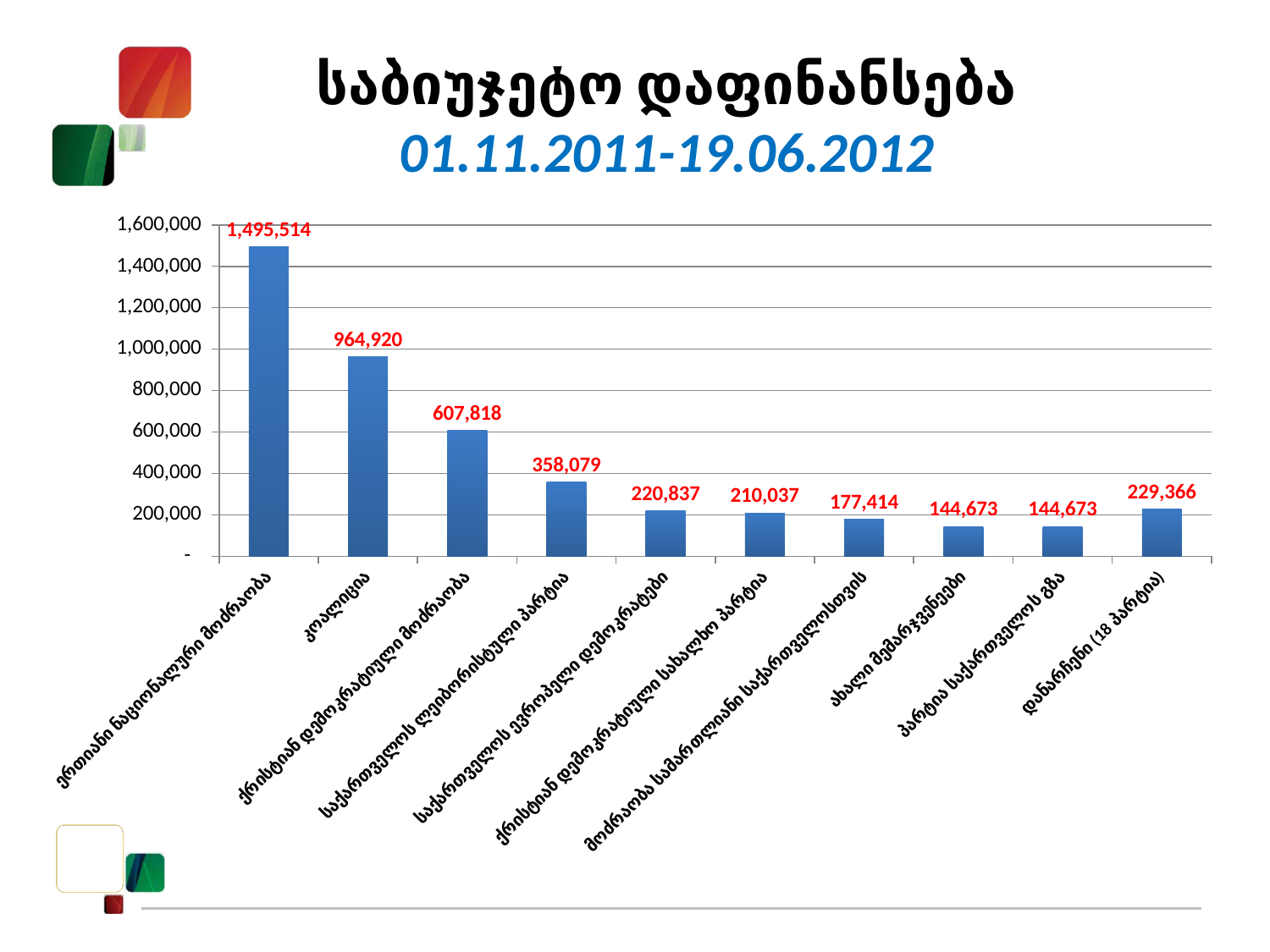
Which is larger, the value for საქართველოს ევროპელი დემოკრატები or the value for დანარჩენი (18 პარტია)? დანარჩენი (18 პარტია) What type of chart is shown on the slide? bar chart Is the value for ქრისტიან დემოკრატიული მოძრაობა greater or less than 800,000? less Which category has the highest value? ერთიანი ნაციონალური მოძრაობა What is the lowest value shown in the chart? 144,673 What is the value for საქართველოს ლეიბორისტული პარტია? 358,079 How many categories are shown in the chart? 10 What is the value for ერთიანი ნაციონალური მოძრაობა? 1,495,514 What date range is given in the slide subtitle? 01.11.2011-19.06.2012 What is the value for კოალიცია? 964,920 What is the difference between the values for ერთიანი ნაციონალური მოძრაობა and კოალიცია? 530,594 What is the value for დანარჩენი (18 პარტია)? 229,366